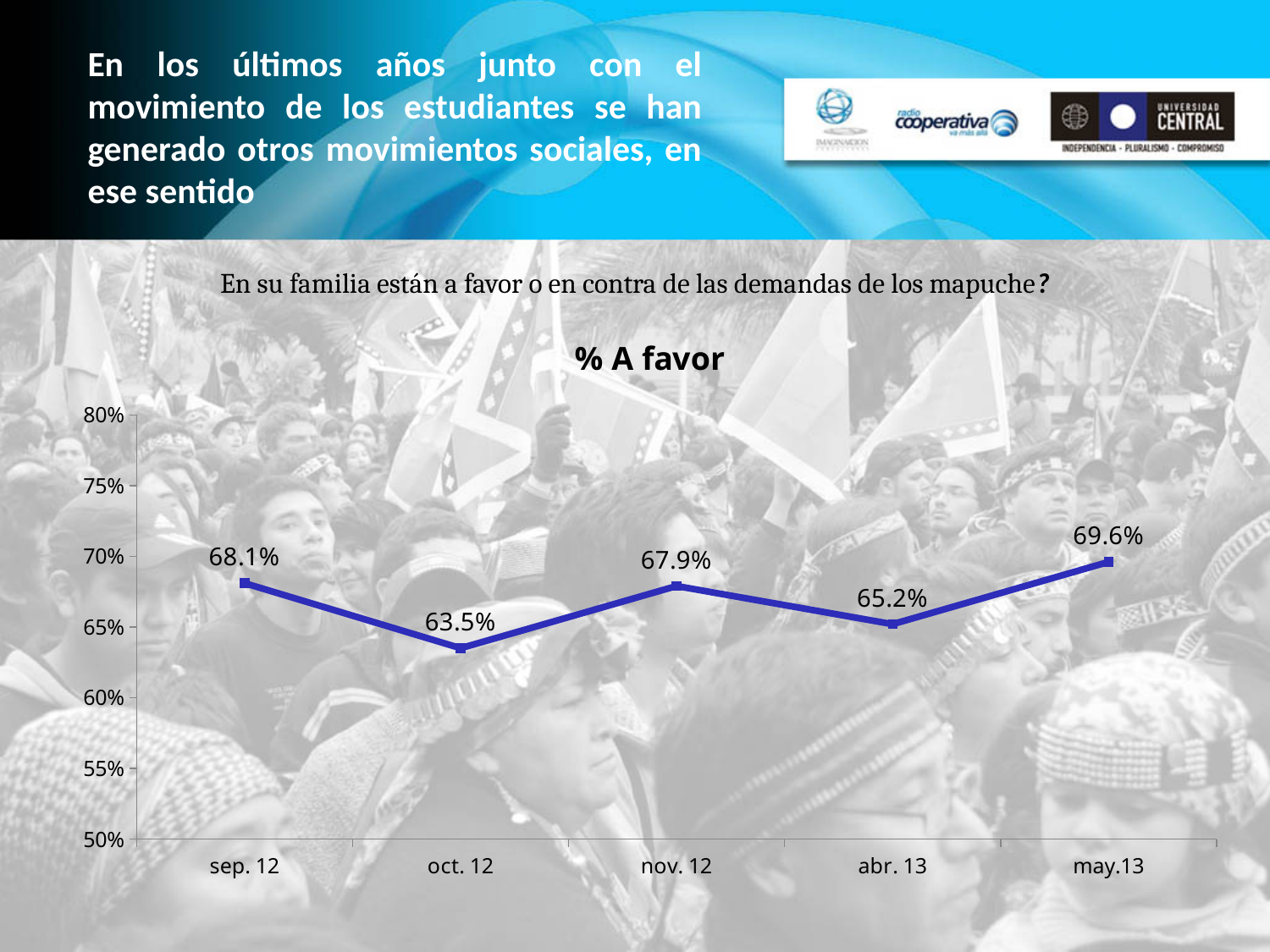
Which is larger, the value for sep. 12 or the value for nov. 12? sep. 12 What is the value for nov. 12? 67.9% How many periods are plotted on the chart? 5 Which period has the highest value? may.13 What is the title of the chart? % A favor What is the value for oct. 12? 63.5% What is the difference between the values for may.13 and oct. 12? 6.1% What kind of chart is shown on the slide? line chart What is the value for sep. 12? 68.1% What is the value for may.13? 69.6% Which period has the lowest value? oct. 12 What is the value for abr. 13? 65.2%